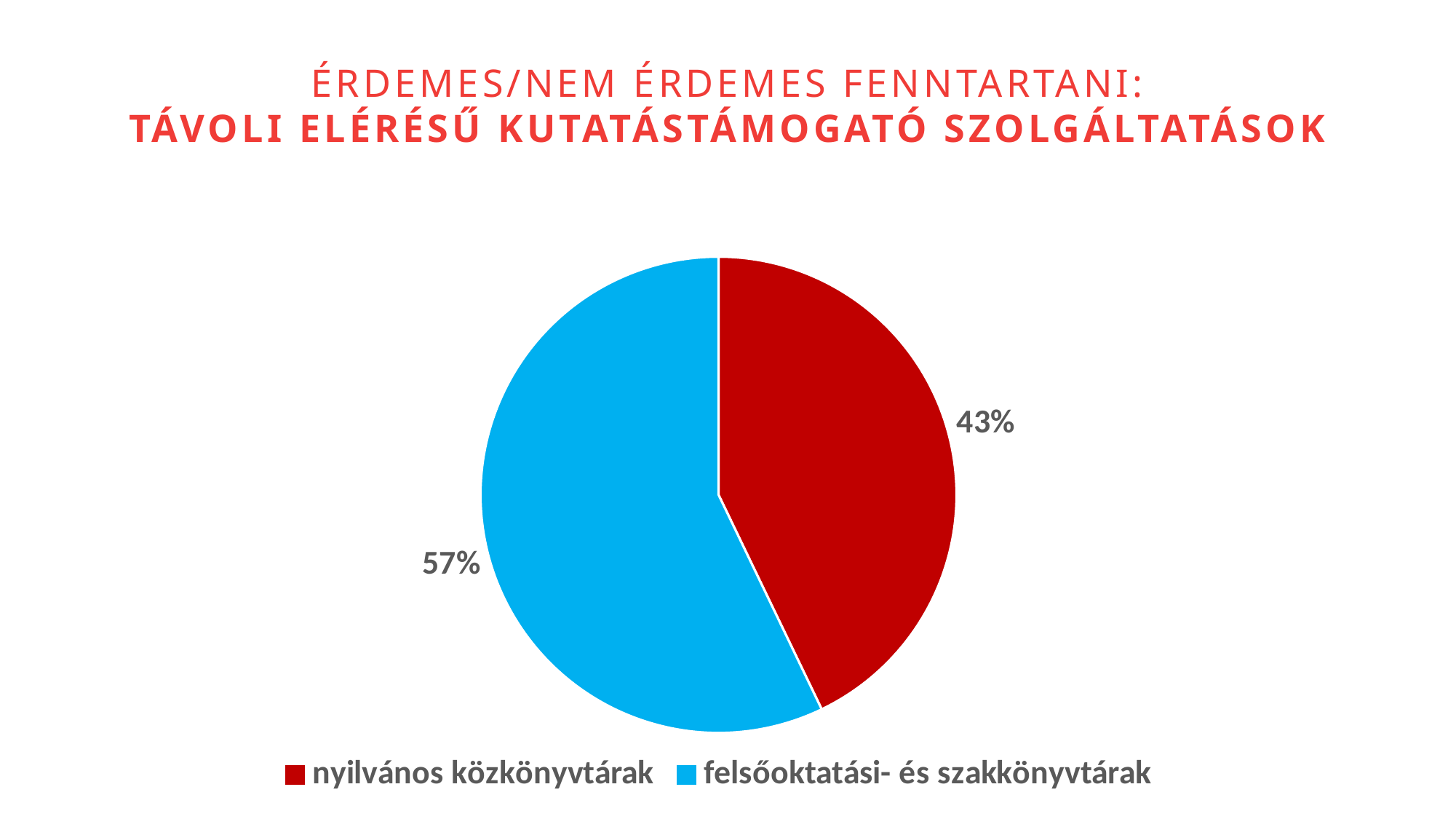
What share of the pie does "felsőoktatási- és szakkönyvtárak" have? 57% How many slices does the pie chart have? 2 Which slice is the smallest? nyilvános közkönyvtárak What colour is the "felsőoktatási- és szakkönyvtárak" slice? blue Which slice is the largest? felsőoktatási- és szakkönyvtárak What colour is the "nyilvános közkönyvtárak" slice? red What kind of chart is shown on the slide? pie chart What is the difference in percentage points between the "felsőoktatási- és szakkönyvtárak" slice and the "nyilvános közkönyvtárak" slice? 14 What share of the pie does "nyilvános közkönyvtárak" have? 43% Which is larger: the share for "nyilvános közkönyvtárak" or the share for "felsőoktatási- és szakkönyvtárak"? felsőoktatási- és szakkönyvtárak How many entries does the legend list? 2